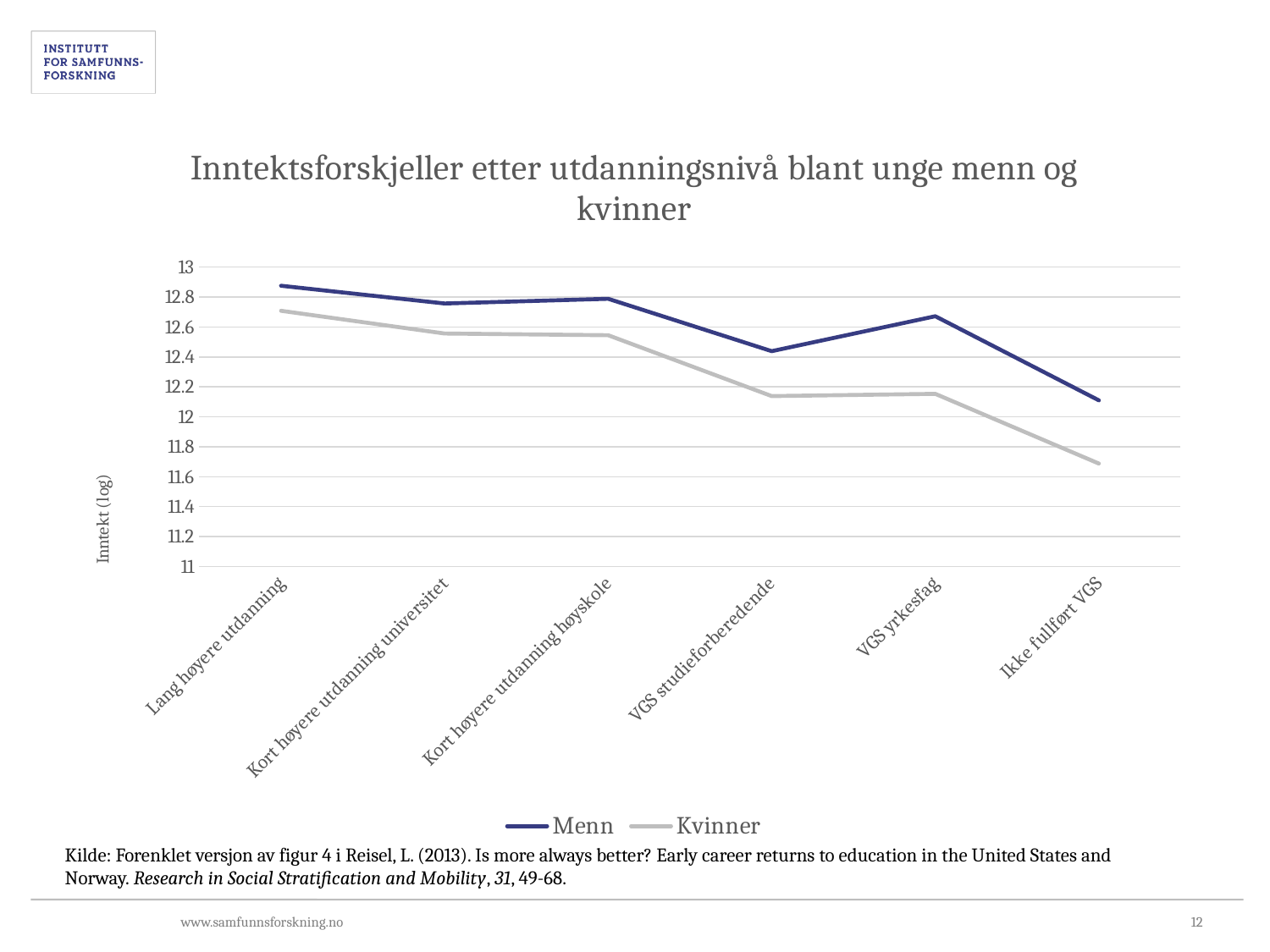
For which category is the Menn value highest? Lang høyere utdanning At VGS yrkesfag, which series has the larger value, Menn or Kvinner? Menn Which series are listed in the legend? Menn and Kvinner For which category is the Kvinner value lowest? Ikke fullført VGS What is the label of the y axis? Inntekt (log) What kind of chart is shown on the slide? line chart For which category is the Menn value lowest? Ikke fullført VGS How many education-level categories are shown on the x axis? 6 How many series does the legend list? 2 Is the Kvinner value for Ikke fullført VGS greater or less than 11.8? less Is the Menn value for VGS studieforberedende greater or less than 12.6? less Do the values for Kvinner generally rise or fall moving from left to right along the x axis? fall